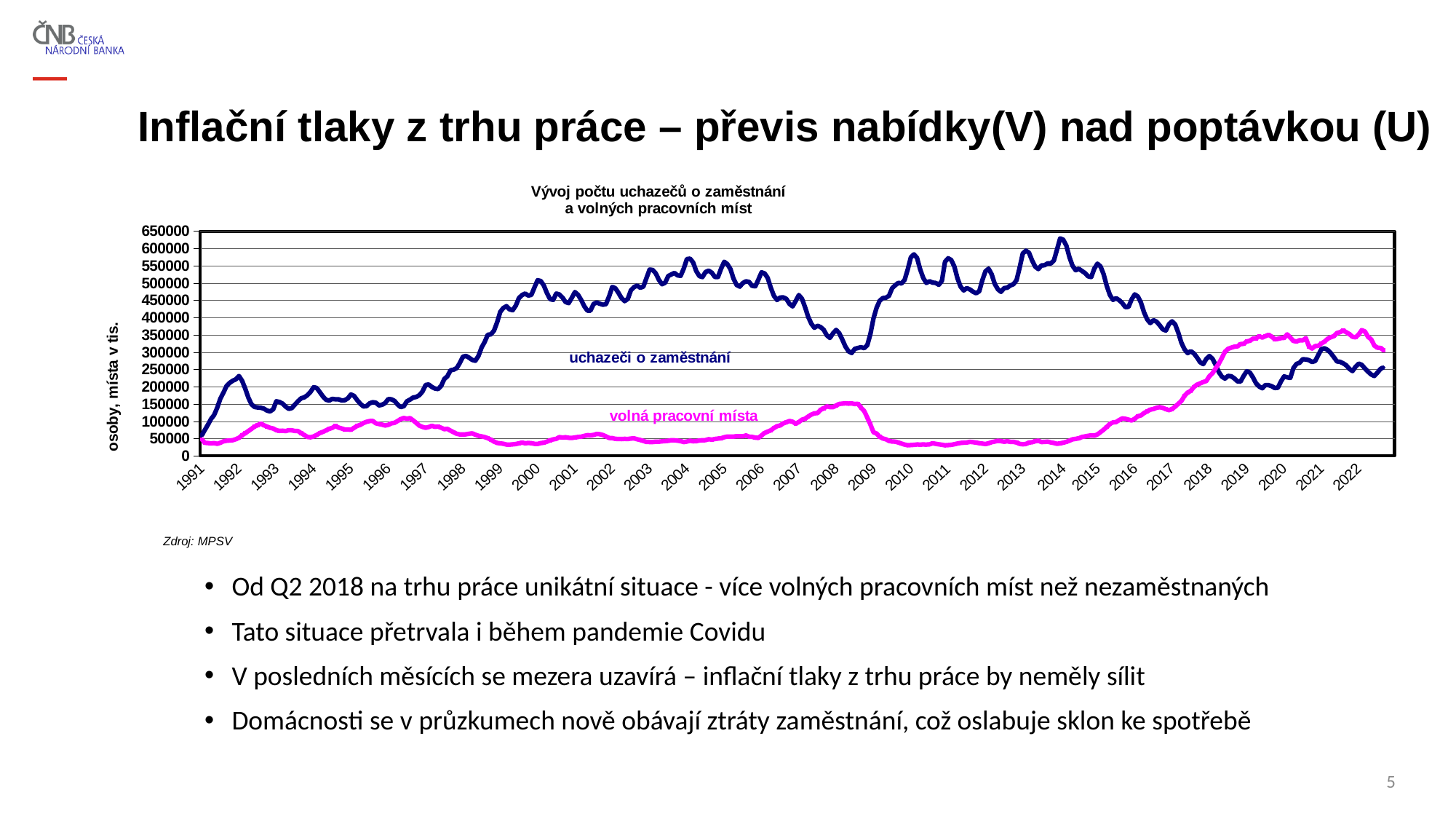
How many series are plotted on the chart? 2 Is the value of 'volná pracovní místa' in 2021 greater or less than 300000? greater What is the title of the chart? Vývoj počtu uchazečů o zaměstnání a volných pracovních míst What colour is the line for 'volná pracovní místa'? magenta In 2010, which series has the higher value: 'uchazeči o zaměstnání' or 'volná pracovní místa'? uchazeči o zaměstnání Is the peak value of 'uchazeči o zaměstnání' around 2014 greater or less than 600000? greater Is the value of 'volná pracovní místa' in 2010 greater or less than 100000? less In 2020, which series has the higher value: 'uchazeči o zaměstnání' or 'volná pracovní místa'? volná pracovní místa Does the 'uchazeči o zaměstnání' line rise or fall between 2014 and 2019? fall Which series reaches the highest value anywhere on the chart? uchazeči o zaměstnání What kind of chart is shown on the slide? line chart